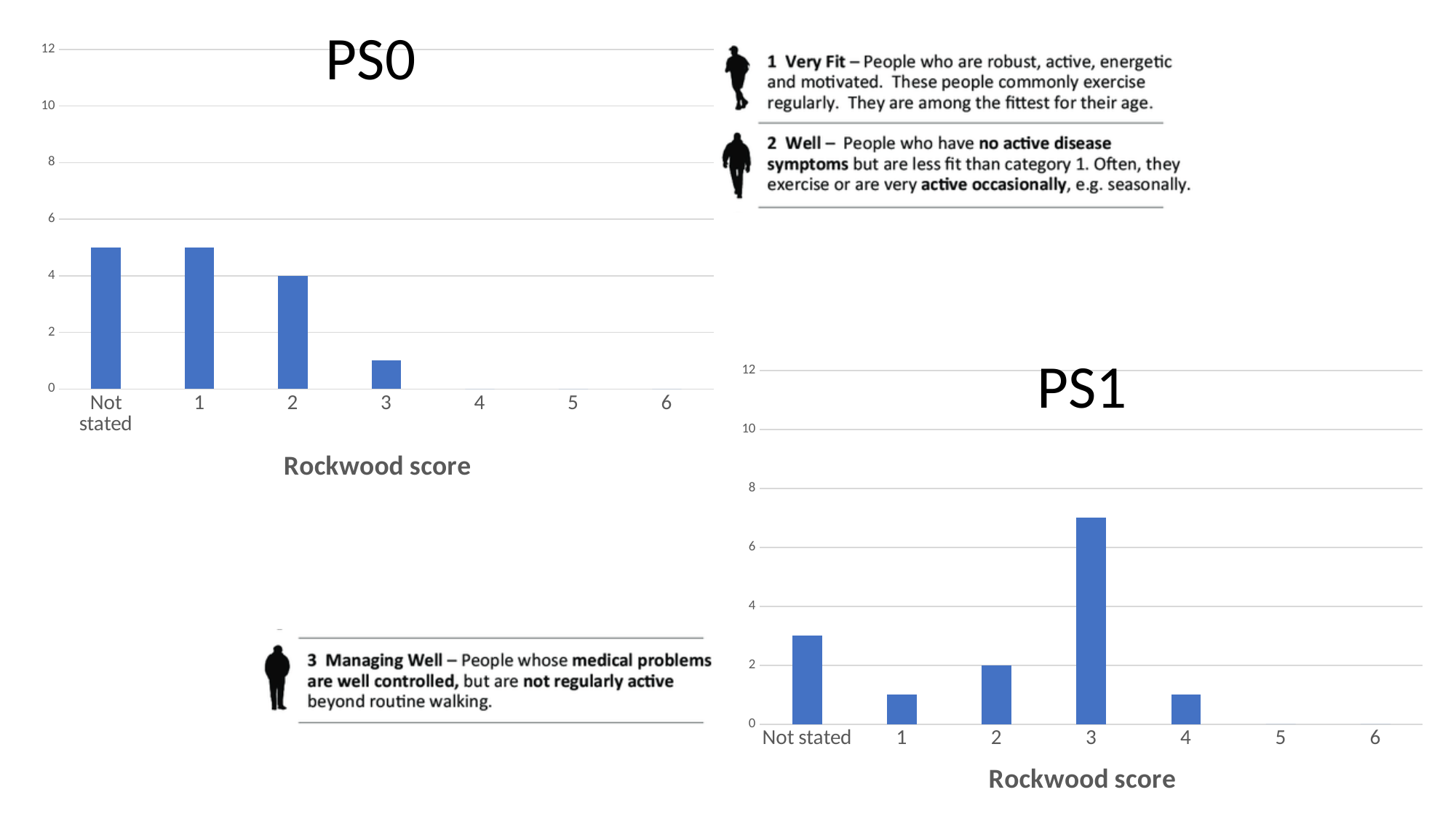
In the PS0 chart, is the value for Not stated greater or less than 4? greater In the PS1 chart, which Rockwood score has the highest value? 3 In the PS0 chart, what is the value for Rockwood score 2? 4 What kind of chart is the PS0 chart? bar chart In the PS0 chart, is the value for Rockwood score 3 greater or less than 2? less In the PS1 chart, which is larger, the value for Rockwood score 3 or Not stated? Rockwood score 3 In the PS1 chart, what is the value for Rockwood score 2? 2 In the PS1 chart, is the value for Not stated greater or less than 2? greater In the PS0 chart, which is larger, the value for Rockwood score 2 or Rockwood score 3? Rockwood score 2 How many categories are shown on the x axis of the PS1 chart? 7 What is the x-axis title of the PS0 chart? Rockwood score